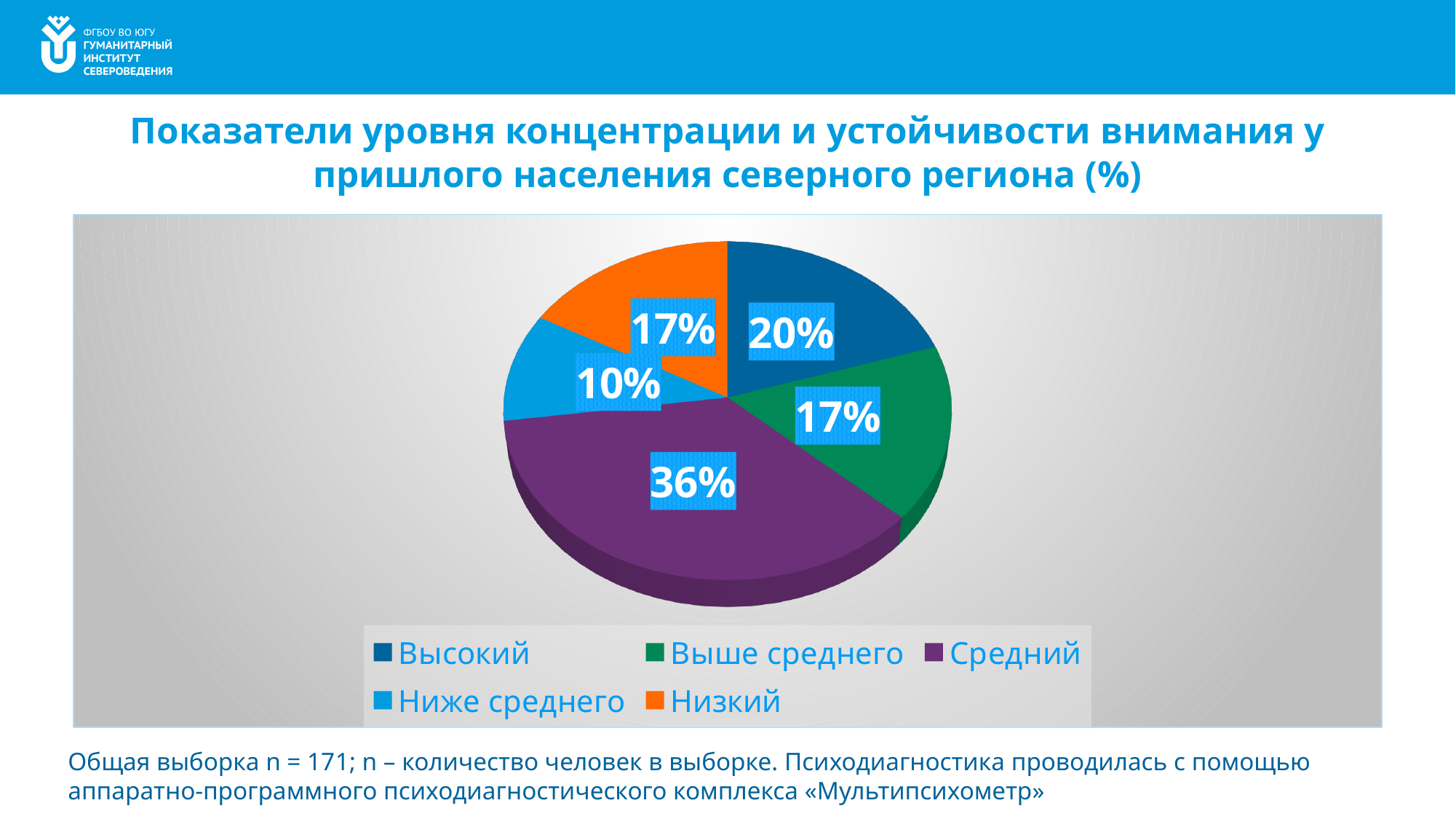
What kind of chart is shown on the slide? pie chart What is the value for Высокий? 20% Which is larger, the value for Высокий or the value for Ниже среднего? Высокий How many categories does the pie chart have? 5 What is the difference between the values for Выше среднего and Ниже среднего? 7% What is the difference between the values for Средний and Высокий? 16% Which category has the largest share of the pie? Средний What is the value for Низкий? 17% What is the value for Ниже среднего? 10% What is the value for Средний? 36% Which category has the smallest share of the pie? Ниже среднего Which colour represents Низкий in the legend? orange